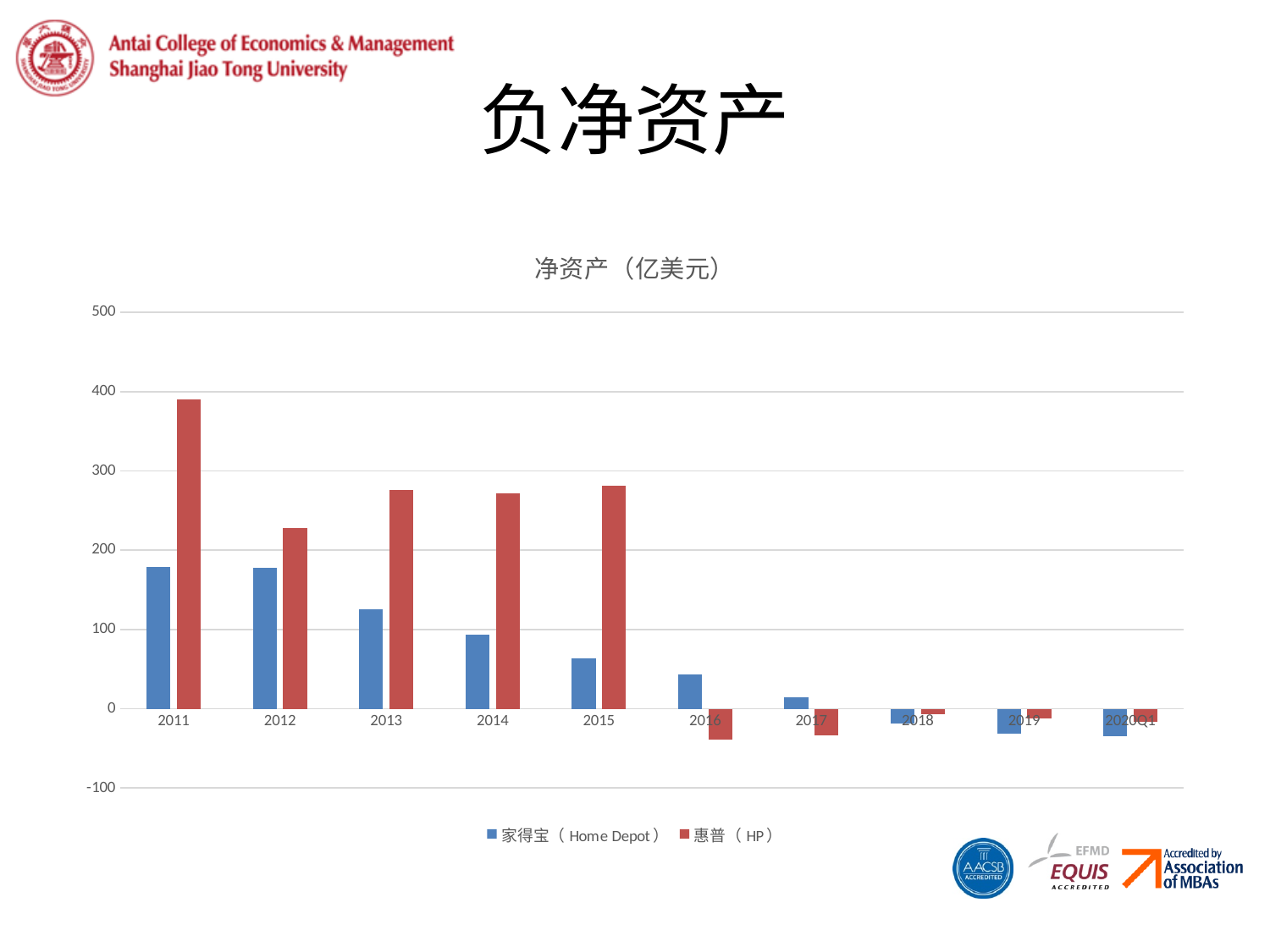
What kind of chart is shown on the slide? bar chart Do the values for 家得宝（Home Depot）rise or fall from 2011 to 2020Q1? fall Is the value for 惠普（HP）in 2011 greater or less than 300? greater What is the title of the chart? 净资产（亿美元） How many series does the legend list? 2 Is the value for 惠普（HP）in 2016 greater or less than 0? less In which year is the value for 惠普（HP）highest? 2011 Is the value for 家得宝（Home Depot）in 2013 greater or less than 100? greater Which is larger in 2014, the value for 家得宝（Home Depot）or the value for 惠普（HP）? 惠普（HP） How many categories are shown on the x axis? 10 In which year is the value for 家得宝（Home Depot）highest? 2011